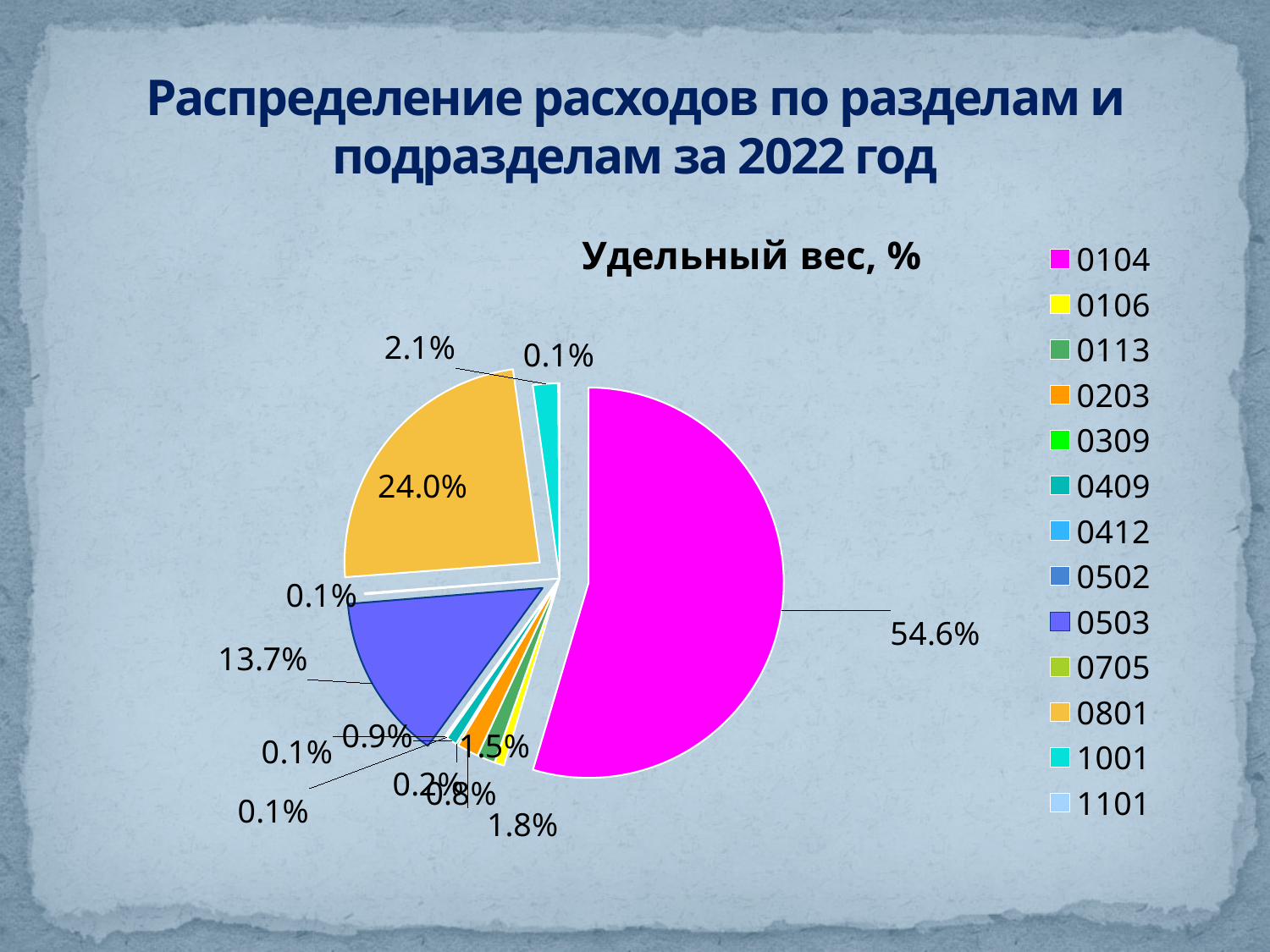
What is the title of the chart? Удельный вес, % Is the share for category 0104 greater or less than 50%? greater What share of the pie does category 0104 have? 54.6% Which category has the largest slice of the pie? 0104 What is the value shown for category 1001? 2.1% What is the value shown for category 0503? 13.7% What kind of chart is shown on the slide? pie chart What is the difference between the values for 0801 and 0503? 10.3% What is the value shown for category 0801? 24.0% Which is larger, the slice for 0801 or the slice for 0503? 0801 What is the difference between the values for 0104 and 0801? 30.6% How many categories does the legend list? 13